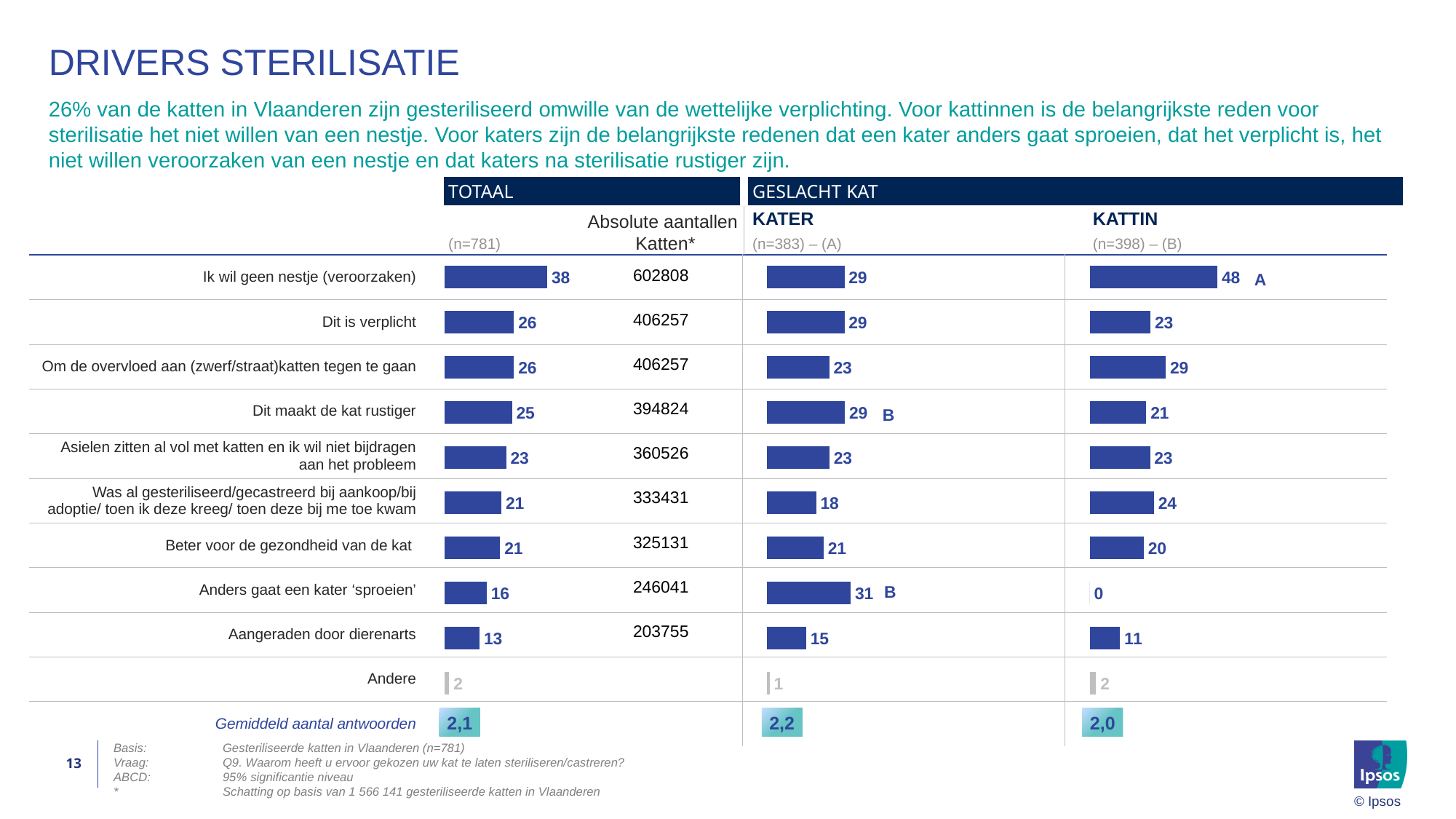
In the KATTIN chart, which category has the lowest value? Anders gaat een kater ‘sproeien’ In the TOTAAL chart, what is the difference between 'Ik wil geen nestje (veroorzaken)' and 'Aangeraden door dierenarts'? 25 In the KATTIN chart, which category has the highest value? Ik wil geen nestje (veroorzaken) What kind of chart is used for the TOTAAL column? Bar chart What is the 'Gemiddeld aantal antwoorden' shown for the KATER column? 2,2 In the KATTIN chart, what is the value for 'Was al gesteriliseerd/gecastreerd bij aankoop/bij adoptie/ toen ik deze kreeg/ toen deze bij me toe kwam'? 24 In the KATER chart, which category has the highest value? Anders gaat een kater ‘sproeien’ In the TOTAAL chart, what is the value for 'Ik wil geen nestje (veroorzaken)'? 38 How many categories are shown in the TOTAAL chart? 10 In the KATER chart, what is the value for 'Anders gaat een kater ‘sproeien’'? 31 For 'Dit maakt de kat rustiger', which is larger: the KATER value or the KATTIN value? KATER What is the difference between the KATTIN and KATER values for 'Ik wil geen nestje (veroorzaken)'? 19